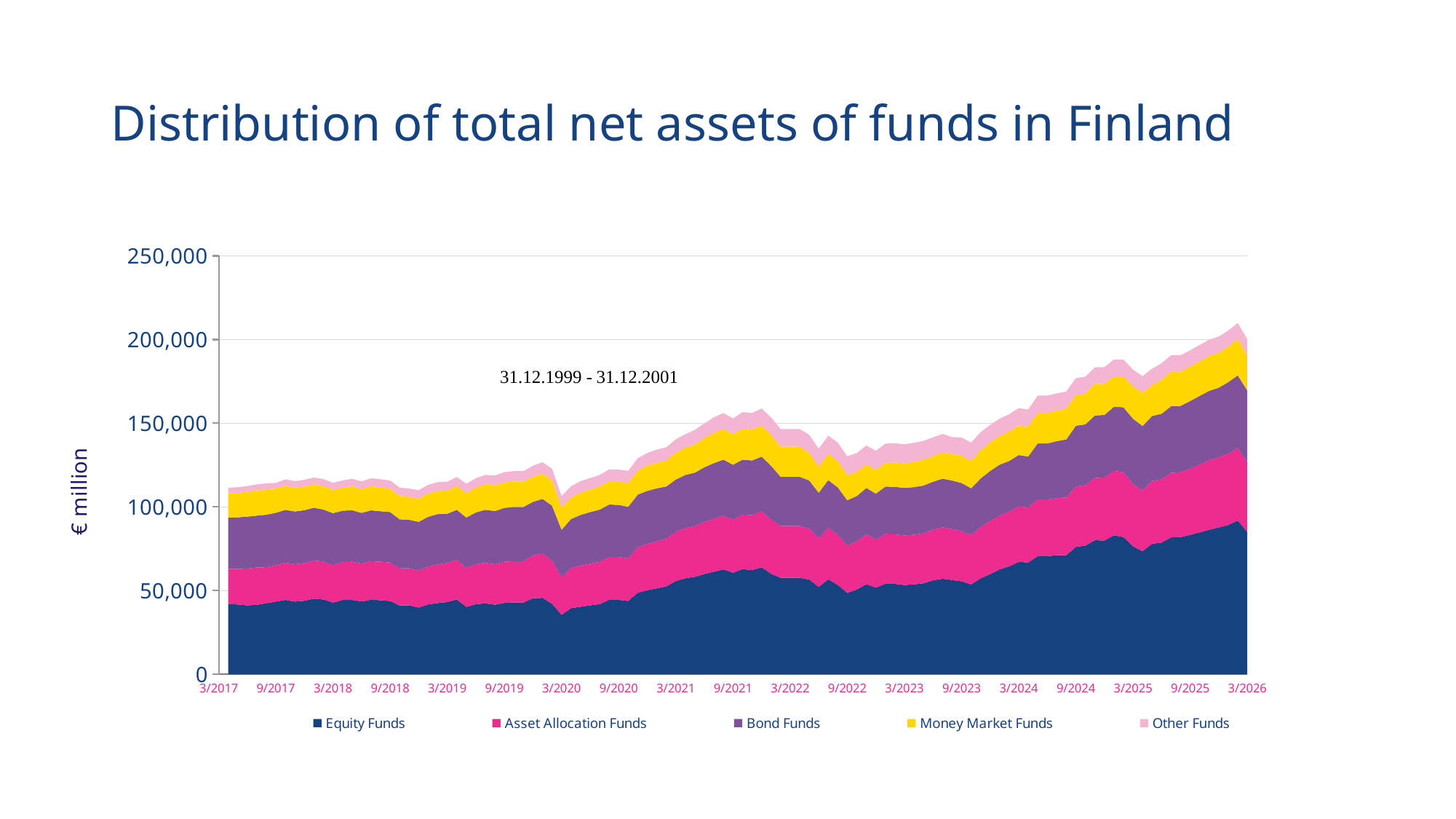
How many date labels are shown along the x axis? 19 How many series does the legend list? 5 What is the label on the vertical axis? € million Is the total net assets value at 3/2024 greater or less than 150,000? greater Does the total net assets value generally rise or fall from 3/2017 to 3/2026? rise What is the title of the chart? Distribution of total net assets of funds in Finland Which series has the largest value at 3/2026? Equity Funds What kind of chart is shown on the slide? Stacked area chart Is the Equity Funds value at 3/2017 greater or less than 50,000? less At 3/2026, which is larger: Equity Funds or Money Market Funds? Equity Funds Is the total net assets value at 3/2017 greater or less than 150,000? less